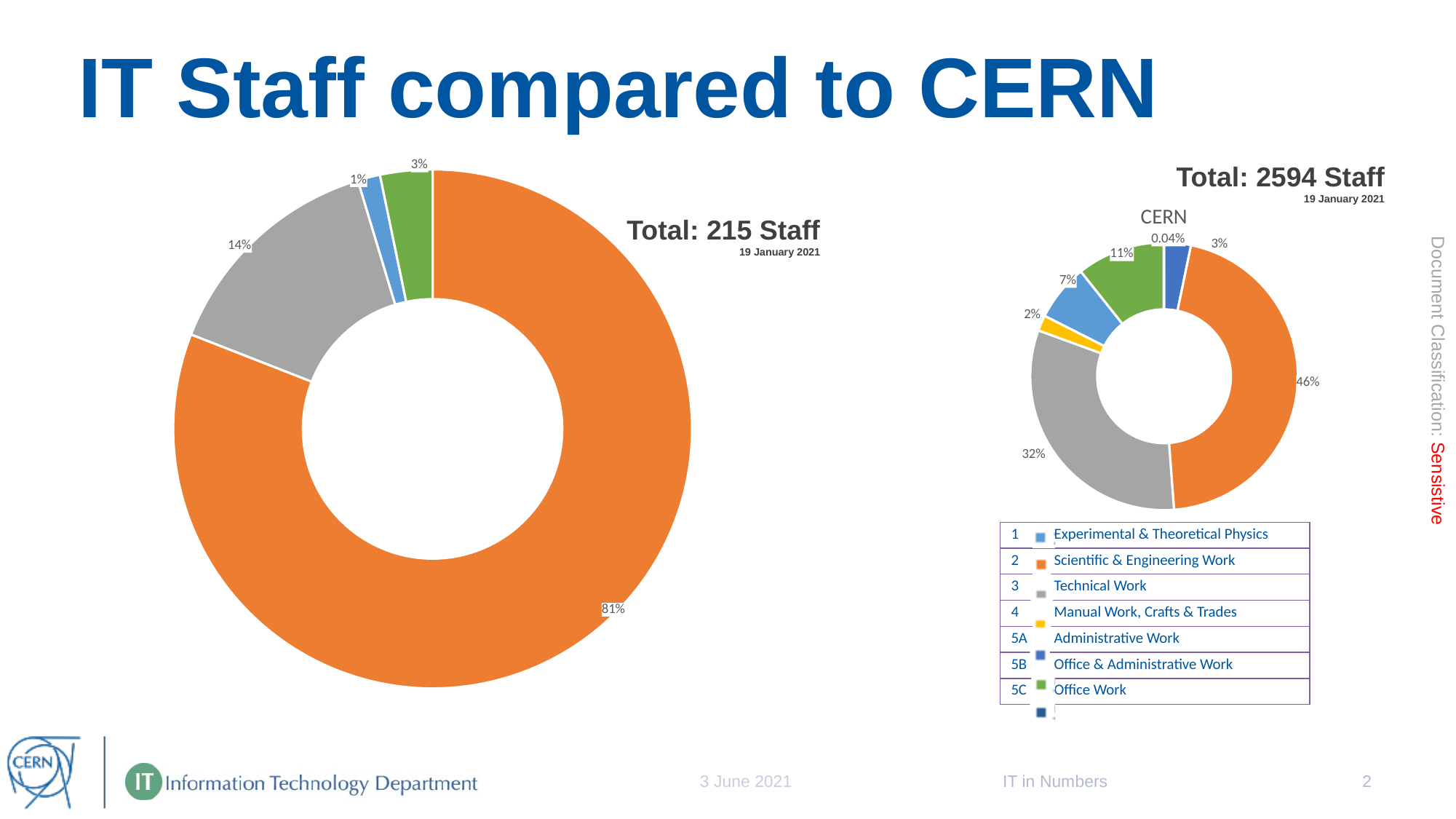
How many labelled categories does the legend list? 7 What kind of chart is used on this slide? doughnut chart What total staff count is shown for the right (CERN) chart? 2594 Staff In the right (CERN) chart, what is the smallest labelled slice's share? 0.04% Is the Office Work (green) share larger in the IT chart or the CERN chart? CERN chart What total staff count is shown for the left (IT) chart? 215 Staff In the left (IT) chart, what share is Technical Work (gray)? 14% In the left (IT) chart, what is the largest slice's share? 81% In the right (CERN) chart, what share is Scientific & Engineering Work (orange)? 46% In the right (CERN) chart, what share is Technical Work (gray)? 32% By how many percentage points does the Scientific & Engineering Work share in the IT chart exceed that in the CERN chart? 35 percentage points